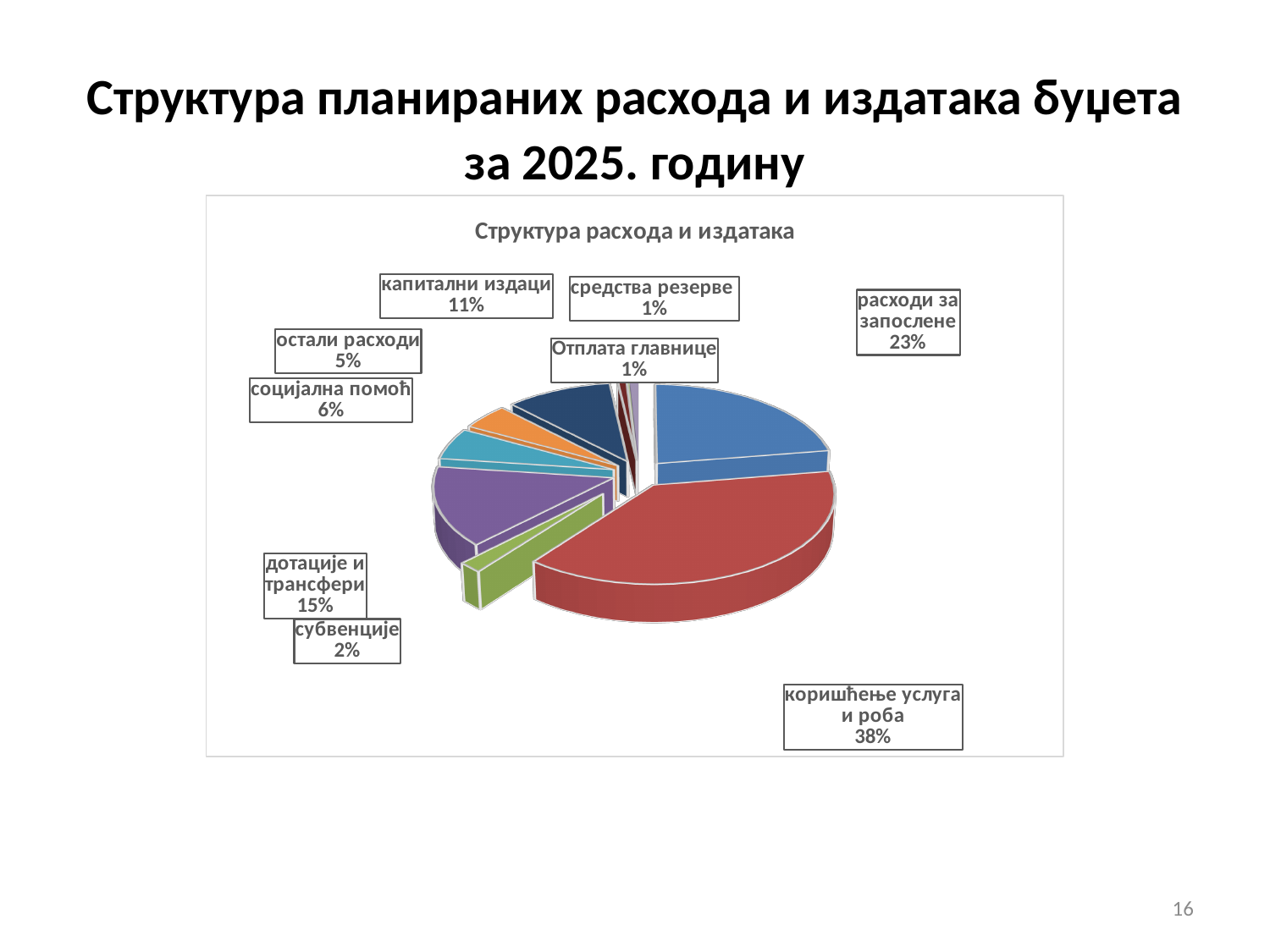
What percentage is shown for субвенције? 2% What share of the pie is коришћење услуга и роба? 38% What percentage is shown for расходи за запослене? 23% What kind of chart is shown on the slide? pie chart Which category has the largest share of the pie? коришћење услуга и роба What is the combined share of средства резерве and Отплата главнице? 2% What percentage is shown for капитални издаци? 11% What percentage is shown for дотације и трансфери? 15% What is the title of the chart? Структура расхода и издатака Which is larger, социјална помоћ or остали расходи? социјална помоћ What is the difference in percentage points between коришћење услуга и роба and расходи за запослене? 15